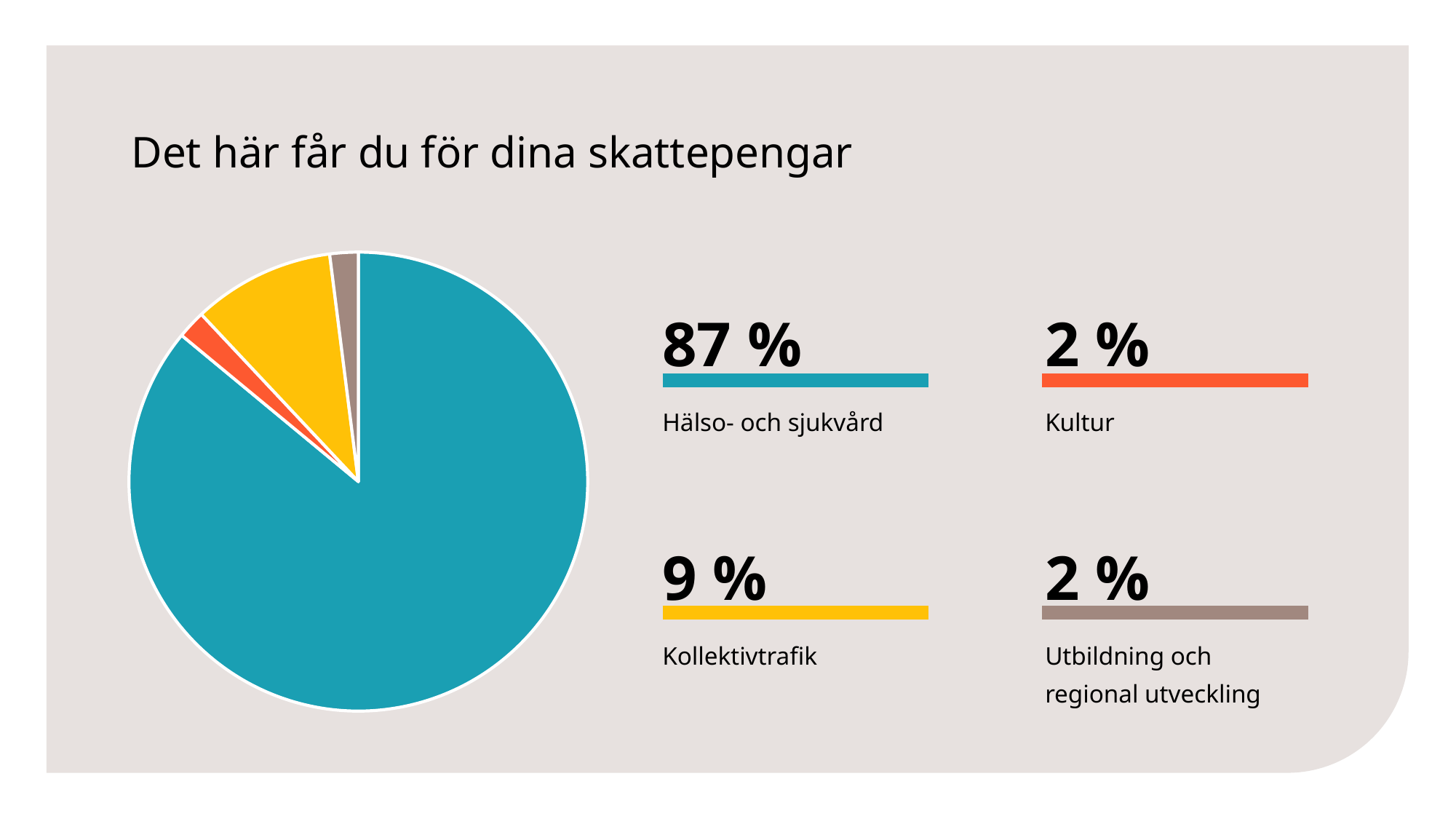
What share of the pie does Kultur represent? 2 % Which category has the largest slice of the pie? Hälso- och sjukvård Which colour represents Kollektivtrafik in the pie chart? yellow What type of chart is shown on the slide? pie chart What share of the pie does Hälso- och sjukvård represent? 87 % What share of the pie does Utbildning och regional utveckling represent? 2 % What is the title of the slide containing the pie chart? Det här får du för dina skattepengar What is the difference in percentage points between Hälso- och sjukvård and Kollektivtrafik? 78 Which is larger, the share for Kollektivtrafik or the share for Kultur? Kollektivtrafik What is the combined share of Kultur and Utbildning och regional utveckling? 4 % How many slices does the pie chart have? 4 What share of the pie does Kollektivtrafik represent? 9 %